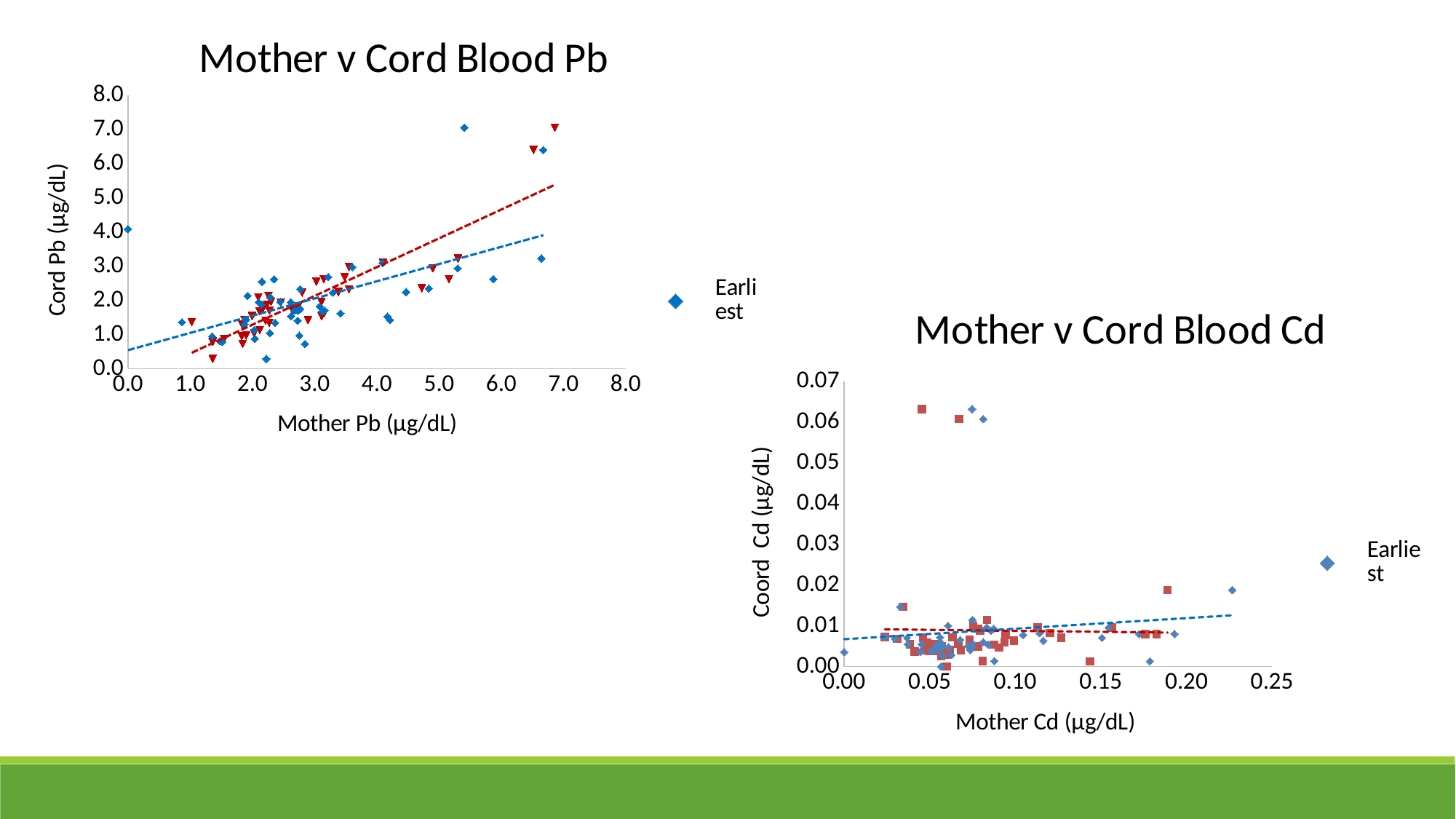
In the 'Mother v Cord Blood Pb' chart, is the highest plotted Cord Pb value greater or less than 6.0? greater What kind of chart is the 'Mother v Cord Blood Cd' chart? Scatter chart In the 'Mother v Cord Blood Cd' chart, what is the label of the y axis? Coord Cd (µg/dL) In the 'Mother v Cord Blood Cd' chart, is the highest plotted Coord Cd value greater or less than 0.05? greater How many charts are shown on the slide? 2 In the 'Mother v Cord Blood Pb' chart, do the dashed trend lines rise or fall as Mother Pb increases? Rise What kind of chart is the 'Mother v Cord Blood Pb' chart? Scatter chart In the 'Mother v Cord Blood Cd' chart, does the blue dashed trend line rise or fall as Mother Cd increases? Rise In the 'Mother v Cord Blood Pb' chart, what is the maximum value shown on the y axis? 8.0 In the 'Mother v Cord Blood Pb' chart, what is the label of the x axis? Mother Pb (µg/dL)